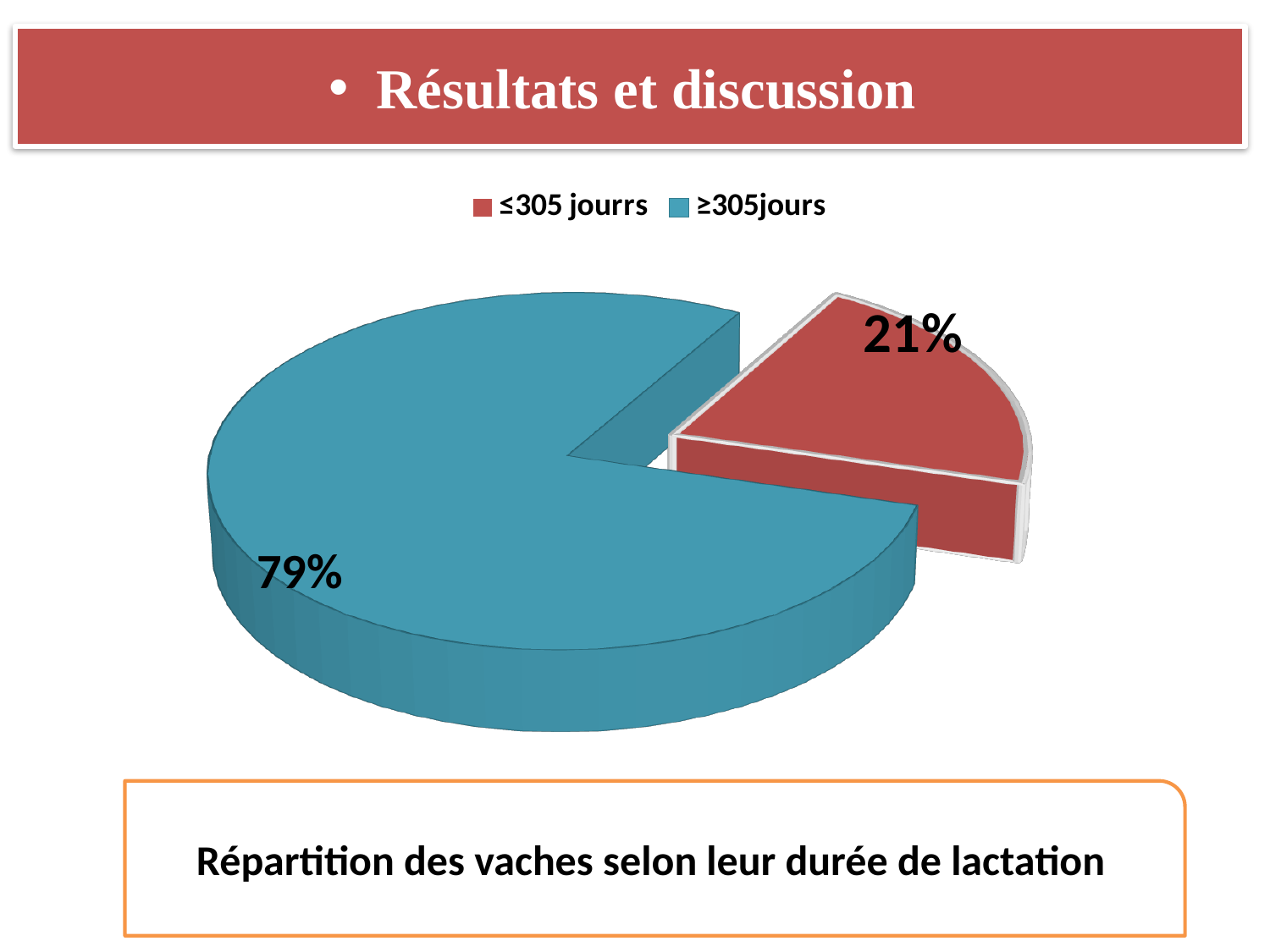
What is the difference in percentage points between the "≥305jours" slice and the "≤305 jourrs" slice? 58 Which category has the largest slice of the pie? ≥305jours How many slices does the pie chart have? 2 Which category has the smallest slice of the pie? ≤305 jourrs What is the caption shown below the pie chart? Répartition des vaches selon leur durée de lactation Which slice is larger, "≤305 jourrs" or "≥305jours"? ≥305jours What share of the pie does the "≥305jours" slice represent? 79% What share of the pie does the "≤305 jourrs" slice represent? 21% How many entries does the legend list? 2 What colour is the "≤305 jourrs" slice? Red What kind of chart is shown on the slide? Pie chart